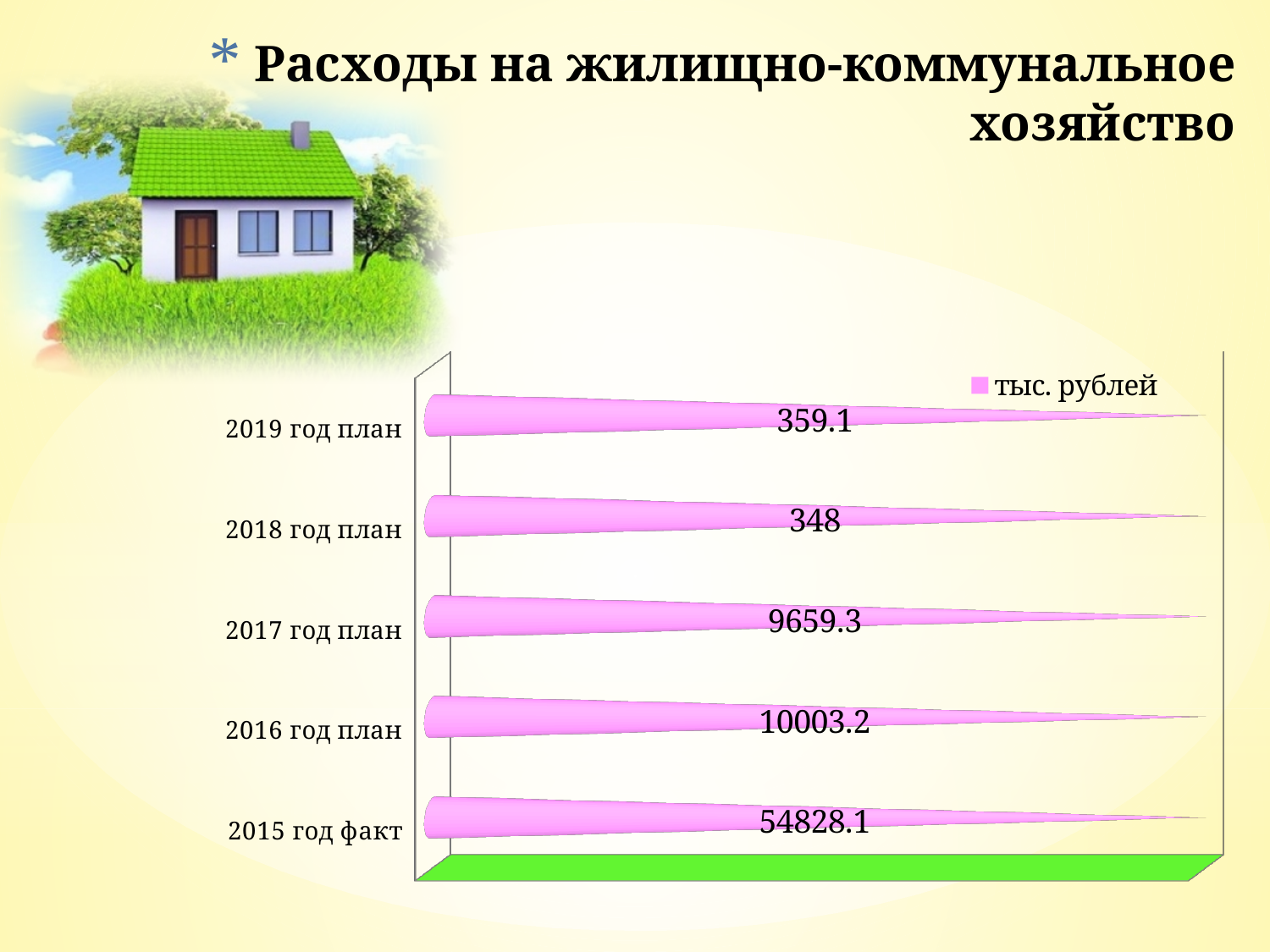
What is the value for 2019 год план? 359.1 What is the value for 2016 год план? 10003.2 How many categories are shown in the chart? 5 Which is larger, the value for 2016 год план or the value for 2017 год план? 2016 год план What kind of chart is shown on the slide? Bar chart Which category has the highest value? 2015 год факт Which category has the lowest value? 2018 год план What is the value for 2015 год факт? 54828.1 What is the difference between the values for 2019 год план and 2018 год план? 11.1 How many series does the legend list? 1 What is the value for 2017 год план? 9659.3 What is the difference between the values for 2016 год план and 2017 год план? 343.9